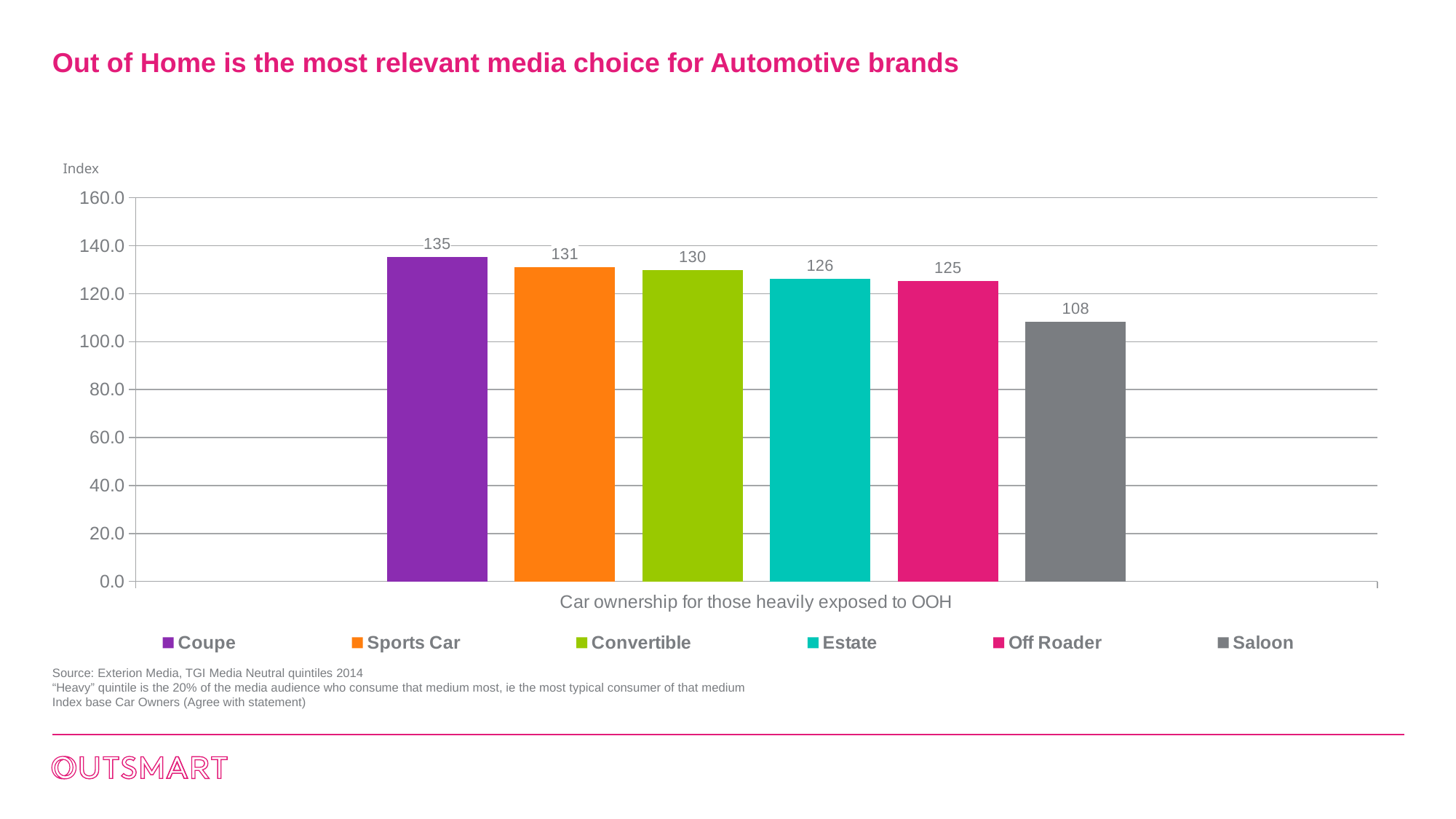
Which car type has the highest index? Coupe What is the index value for Coupe? 135 Is the value for Off Roader greater or less than 120? greater What is the difference between the index for Coupe and the index for Saloon? 27 What kind of chart is shown on the slide? Bar chart What is the x-axis label of the chart? Car ownership for those heavily exposed to OOH How many car types are shown in the chart? 6 Which car type has the lowest index? Saloon What is the difference between the index for Sports Car and the index for Off Roader? 6 What is the index value for Saloon? 108 What is the index value for Estate? 126 Which has a higher index, Convertible or Saloon? Convertible